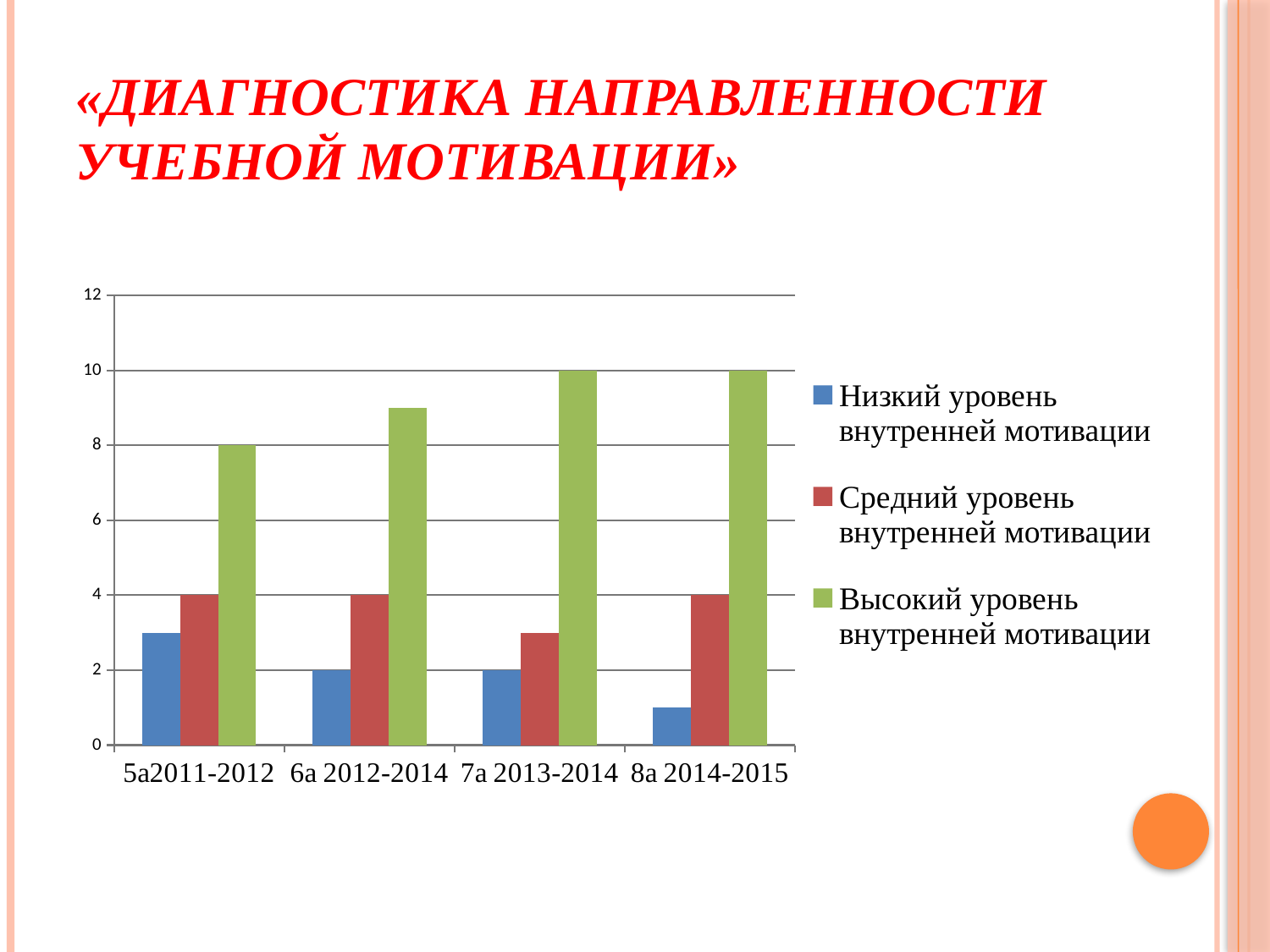
What is the value of Высокий уровень внутренней мотивации for 5а2011-2012? 8 Is the value of Высокий уровень внутренней мотивации for 6а 2012-2014 greater or less than 8? greater Does the value of Высокий уровень внутренней мотивации rise or fall from 5а2011-2012 to 8а 2014-2015? rise Which category has the lowest value for Низкий уровень внутренней мотивации? 8а 2014-2015 What is the value of Высокий уровень внутренней мотивации for 7а 2013-2014? 10 Which colour represents Средний уровень внутренней мотивации in the legend? red What is the value of Средний уровень внутренней мотивации for 8а 2014-2015? 4 What kind of chart is shown on the slide? bar chart How many categories are shown on the x axis? 4 How many series does the legend list? 3 What is the value of Низкий уровень внутренней мотивации for 6а 2012-2014? 2 Is the value of Низкий уровень внутренней мотивации for 8а 2014-2015 greater or less than 2? less